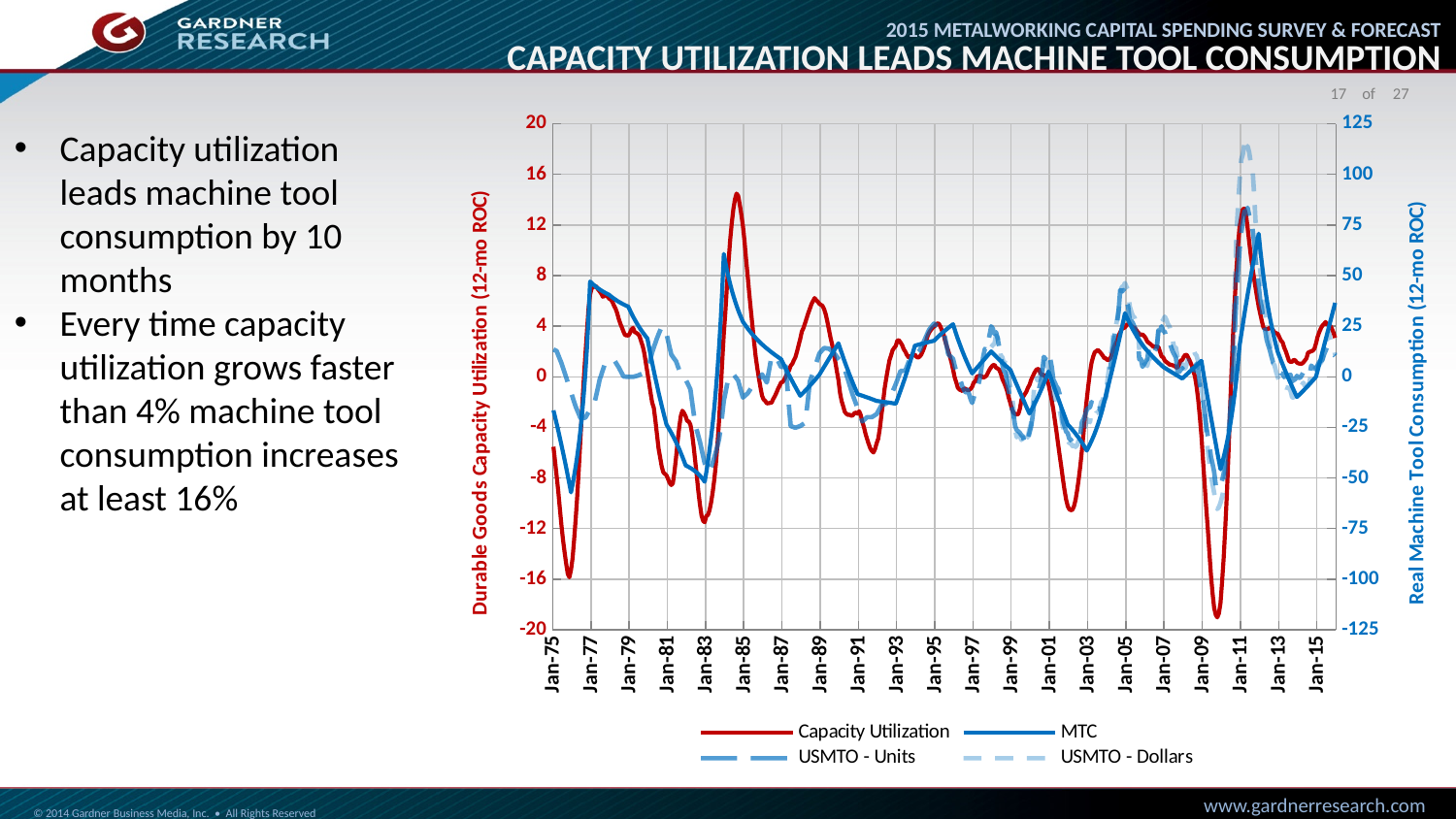
Is the peak of the Capacity Utilization series near Jan-85 greater or less than 12 on the left axis? greater What kind of chart is shown on the slide? line chart Does the Capacity Utilization series rise or fall between Jan-83 and Jan-85? rise Is the lowest value of the Capacity Utilization series, reached between Jan-09 and Jan-11, greater or less than -16 on the left axis? less What is the title of the left vertical axis of the chart? Durable Goods Capacity Utilization (12-mo ROC) Which is higher for the Capacity Utilization series: its peak near Jan-85 or its trough between Jan-09 and Jan-11? peak near Jan-85 How many series does the chart's legend list? 4 Does the Capacity Utilization series rise or fall between Jan-07 and its trough before Jan-11? fall How many date labels are shown along the x axis of the chart? 21 Is the peak of the USMTO - Units series near Jan-11 greater or less than 100 on the right axis? less What is the title of the right vertical axis of the chart? Real Machine Tool Consumption (12-mo ROC)